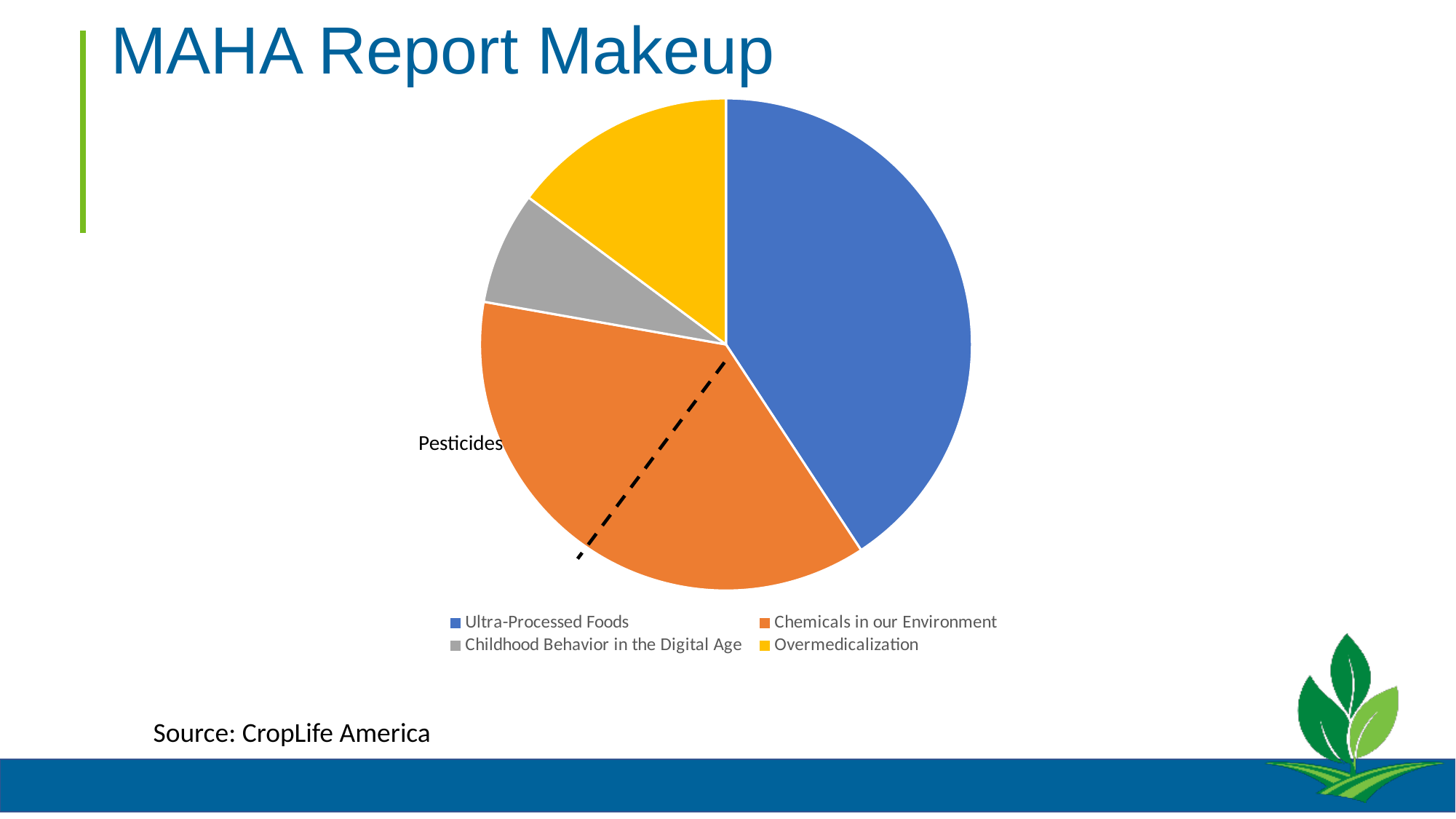
Which slice is larger: Overmedicalization or Childhood Behavior in the Digital Age? Overmedicalization Which category has the largest slice of the pie? Ultra-Processed Foods Which slice is larger: Chemicals in our Environment or Overmedicalization? Chemicals in our Environment How many entries does the legend list? 4 What is the title of the slide containing the pie chart? MAHA Report Makeup What kind of chart is shown on the slide? Pie chart Which category has the smallest slice of the pie? Childhood Behavior in the Digital Age Which slice is larger: Ultra-Processed Foods or Chemicals in our Environment? Ultra-Processed Foods What colour is the Overmedicalization slice in the pie chart? Yellow How many slices does the pie chart have? 4